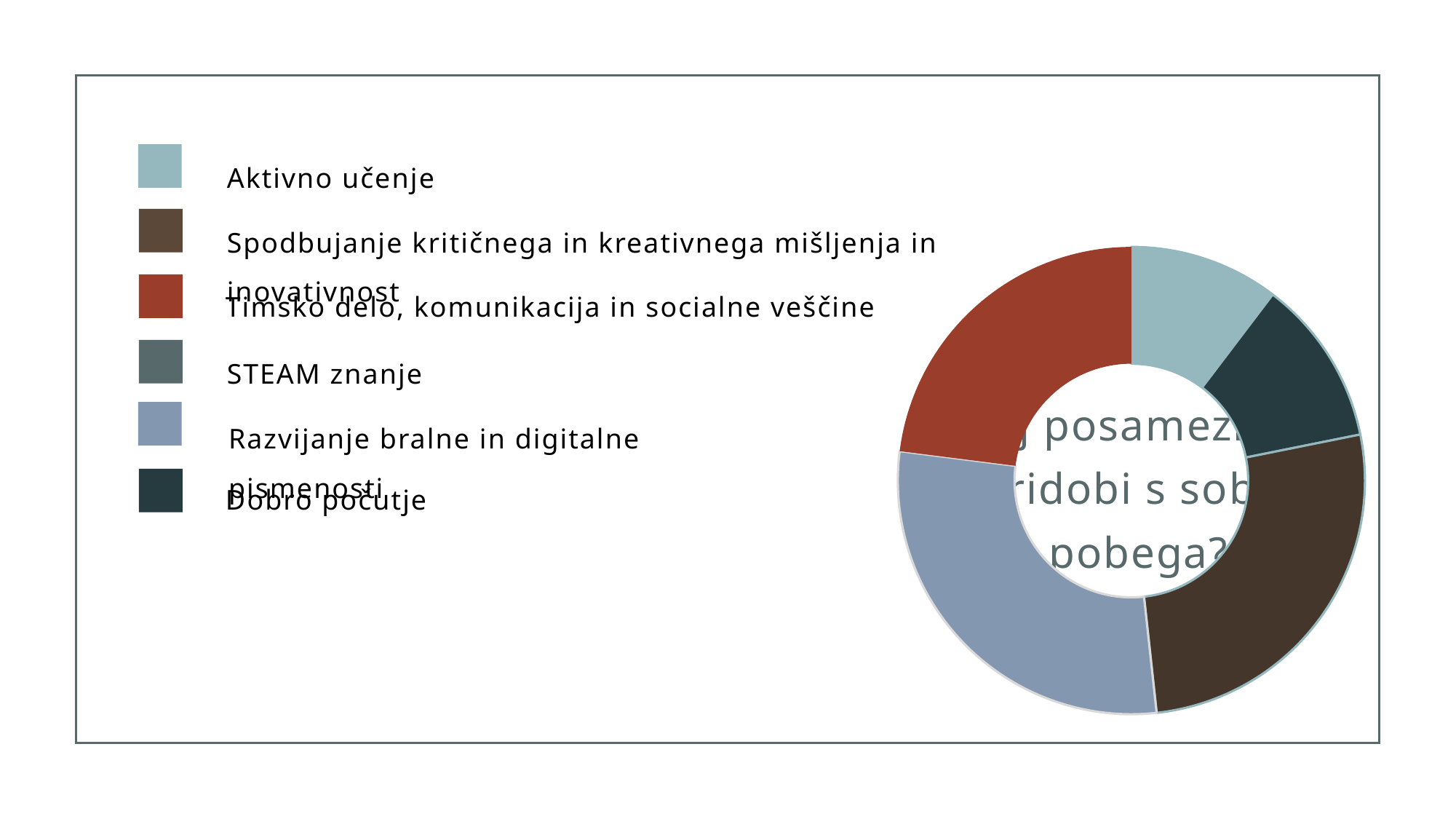
How many categories does the legend of the chart list? 6 Which legend entry is shown in dark brown in the chart? Spodbujanje kritičnega in kreativnega mišljenja in inovativnost Which is larger in the chart: the slice for Spodbujanje kritičnega in kreativnega mišljenja in inovativnost or the slice for Dobro počutje? Spodbujanje kritičnega in kreativnega mišljenja in inovativnost How many data series does the chart plot? 1 Which legend entry is shown in red in the chart? Timsko delo, komunikacija in socialne veščine Which is larger in the chart: the slice for Timsko delo, komunikacija in socialne veščine or the slice for Aktivno učenje? Timsko delo, komunikacija in socialne veščine Which is larger in the chart: the slice for Razvijanje bralne in digitalne pismenosti or the slice for Aktivno učenje? Razvijanje bralne in digitalne pismenosti What kind of chart is shown on the slide? Pie chart (donut)